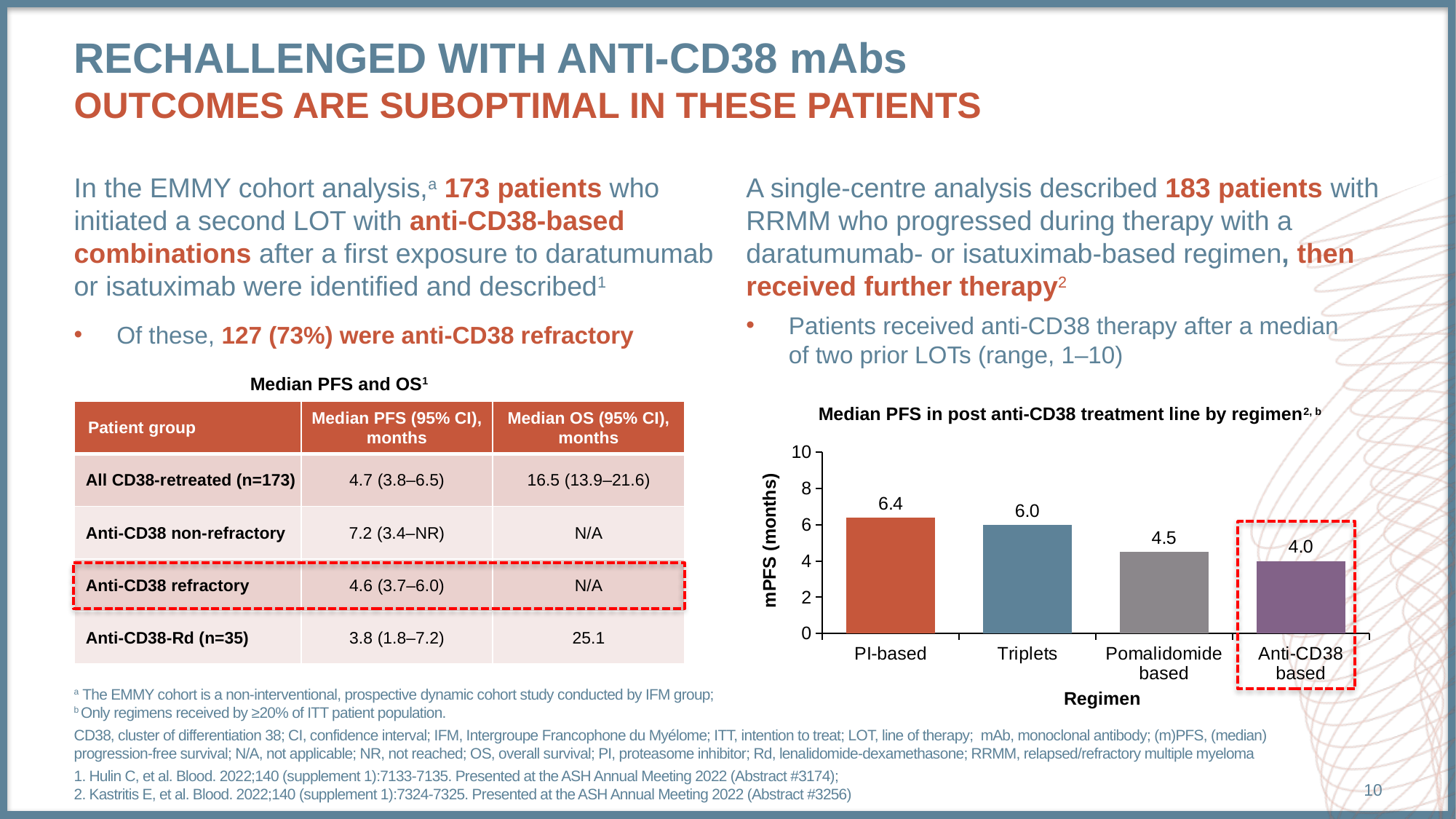
What is the median PFS for the Pomalidomide based regimen in the bar chart? 4.5 Which regimen has the lowest median PFS in the bar chart? Anti-CD38 based What is the title of the bar chart? Median PFS in post anti-CD38 treatment line by regimen Which regimen has a higher median PFS, Triplets or Pomalidomide based? Triplets What is the median PFS for the PI-based regimen in the bar chart? 6.4 What is the median PFS for the Anti-CD38 based regimen in the bar chart? 4.0 What is the difference in median PFS between the PI-based and Anti-CD38 based regimens? 2.4 Which regimen has the highest median PFS in the bar chart? PI-based What is the median PFS for the Triplets regimen in the bar chart? 6.0 How many regimens are shown in the bar chart? 4 Do the median PFS values rise or fall from left to right across the regimens in the bar chart? Fall What type of chart is used to show median PFS by regimen? Bar chart